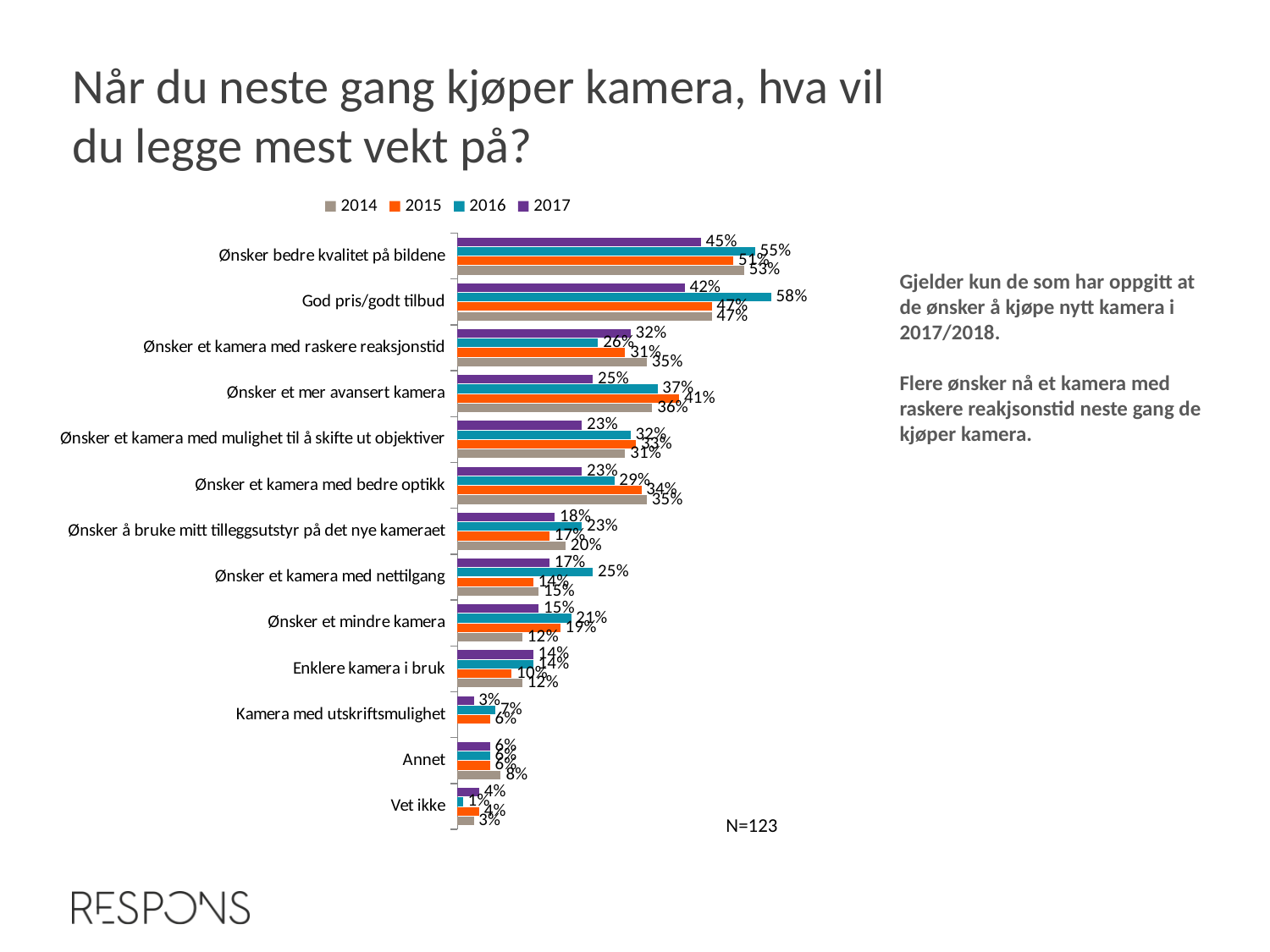
For "Ønsker et mer avansert kamera", which year has the larger value, 2015 or 2017? 2015 What is the sample size (N) shown on the chart? N=123 Which category has the highest 2016 value? God pris/godt tilbud What kind of chart is shown on the slide? Bar chart What is the difference between the 2016 and 2017 values for "God pris/godt tilbud"? 16 percentage points What is the 2016 value for "Ønsker et kamera med nettilgang"? 25% What is the 2016 value for "God pris/godt tilbud"? 58% How many categories are shown on the chart? 13 What is the 2017 value for "Ønsker et kamera med raskere reaksjonstid"? 32% How many series does the legend list? 4 Which category has the lowest 2017 value? Kamera med utskriftsmulighet What is the 2017 value for "Ønsker bedre kvalitet på bildene"? 45%